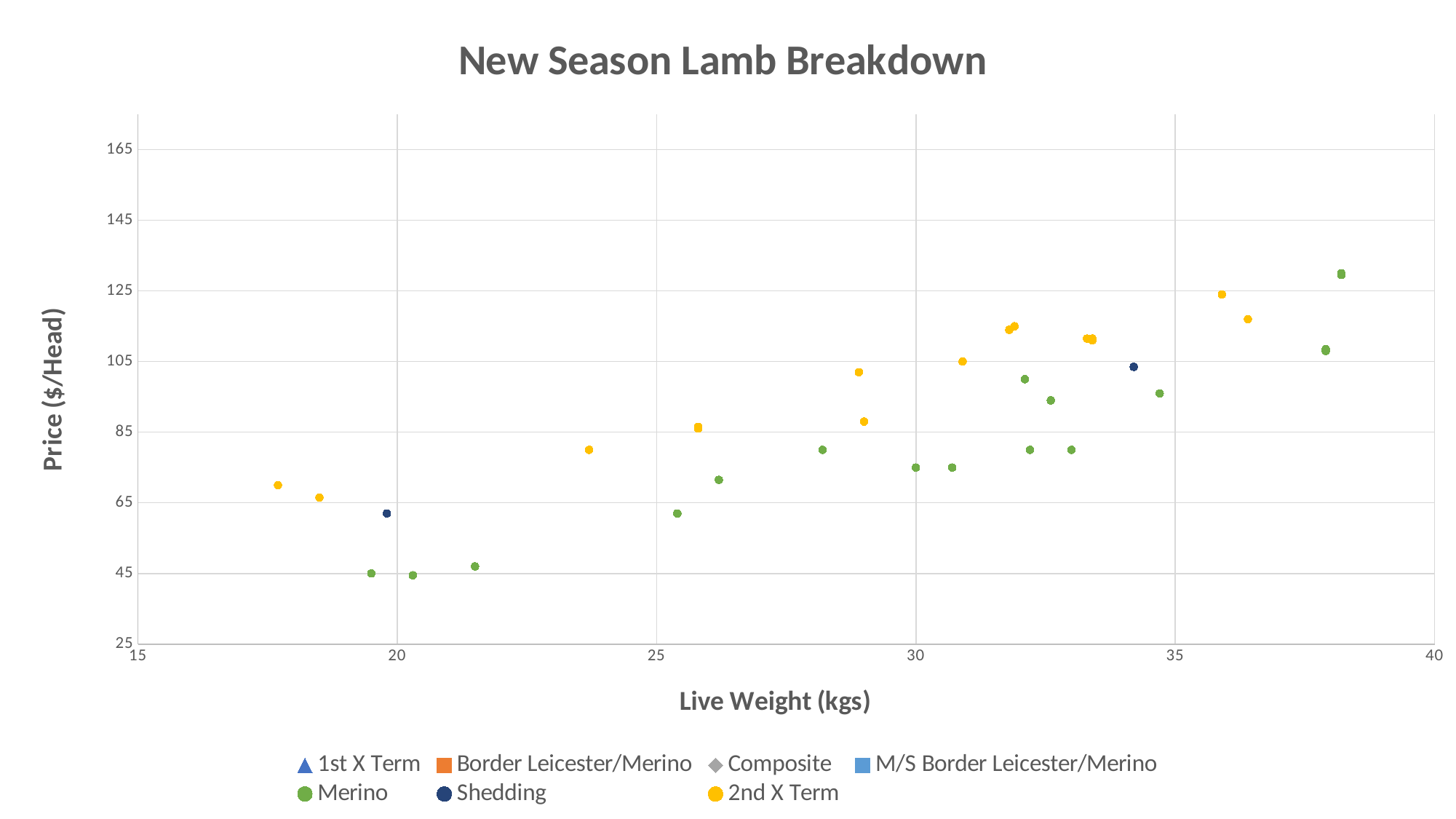
How many Shedding points are plotted? 2 Is the price of the Shedding point near 34 kg greater or less than 85? greater Is the price of the Shedding point near 20 kg greater or less than 85? less What is the label of the vertical axis? Price ($/Head) What is the title of the chart? New Season Lamb Breakdown Is the price of the highest Merino point greater or less than 125? greater What kind of chart is shown on the slide? scatter chart Overall, does price rise or fall as live weight increases? rise Which series contains the lowest-priced point on the chart? Merino How many series does the legend list? 7 Which is higher in price: the Shedding point near 34 kg or the Shedding point near 20 kg? the Shedding point near 34 kg Which series contains the highest-priced point on the chart? Merino